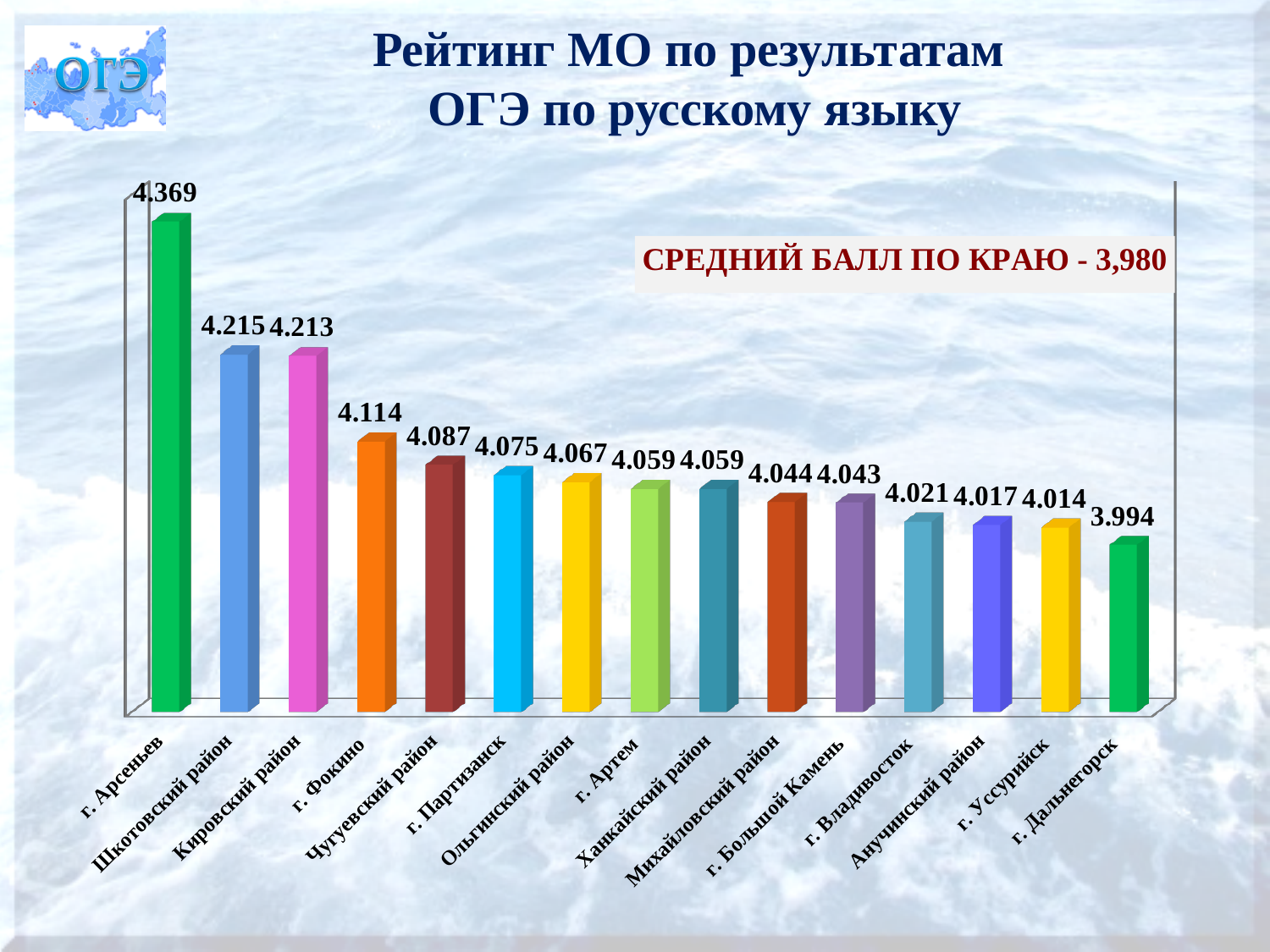
Do the values rise or fall from left to right along the x axis? fall Which category has the lowest value? г. Дальнегорск What is the value for г. Владивосток? 4.021 What is the value for г. Арсеньев? 4.369 Which category has the highest value? г. Арсеньев What kind of chart is shown on the slide? bar chart How many categories are shown in the chart? 15 What is the difference between the values for г. Фокино and Чугуевский район? 0.027 Which is larger, the value for г. Фокино or the value for г. Уссурийск? г. Фокино What is the difference between the values for г. Арсеньев and г. Дальнегорск? 0.375 What is the value for Чугуевский район? 4.087 What average score for the region (край) is stated on the slide? 3,980